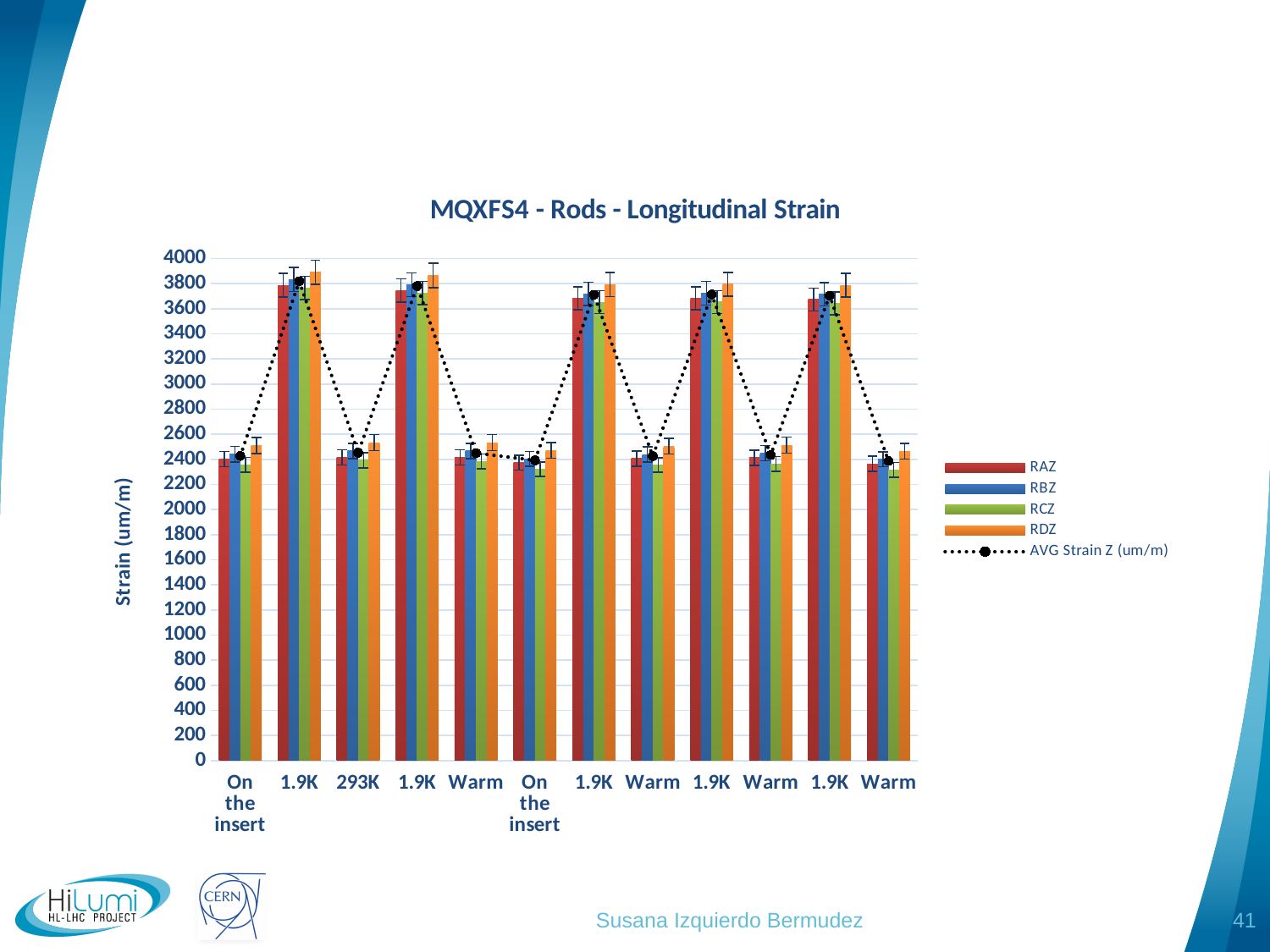
Which series has the lowest value at the first 'On the insert' category? RCZ Is the RDZ value for the first 1.9K category greater or less than 3000? greater What kind of chart is shown on the slide? combination bar and line chart How many categories are shown along the x axis of the chart? 12 What is the title of the chart? MQXFS4 - Rods - Longitudinal Strain Which is larger for RAZ: the value at the first 1.9K category or the value at the 293K category? the first 1.9K category How many entries does the chart legend list? 5 Is the RCZ value for the first 'On the insert' category greater or less than 2600? less Is the RAZ value for the 293K category greater or less than 3000? less What is the label of the y axis? Strain (um/m) Which series has the highest value at the first 1.9K category? RDZ